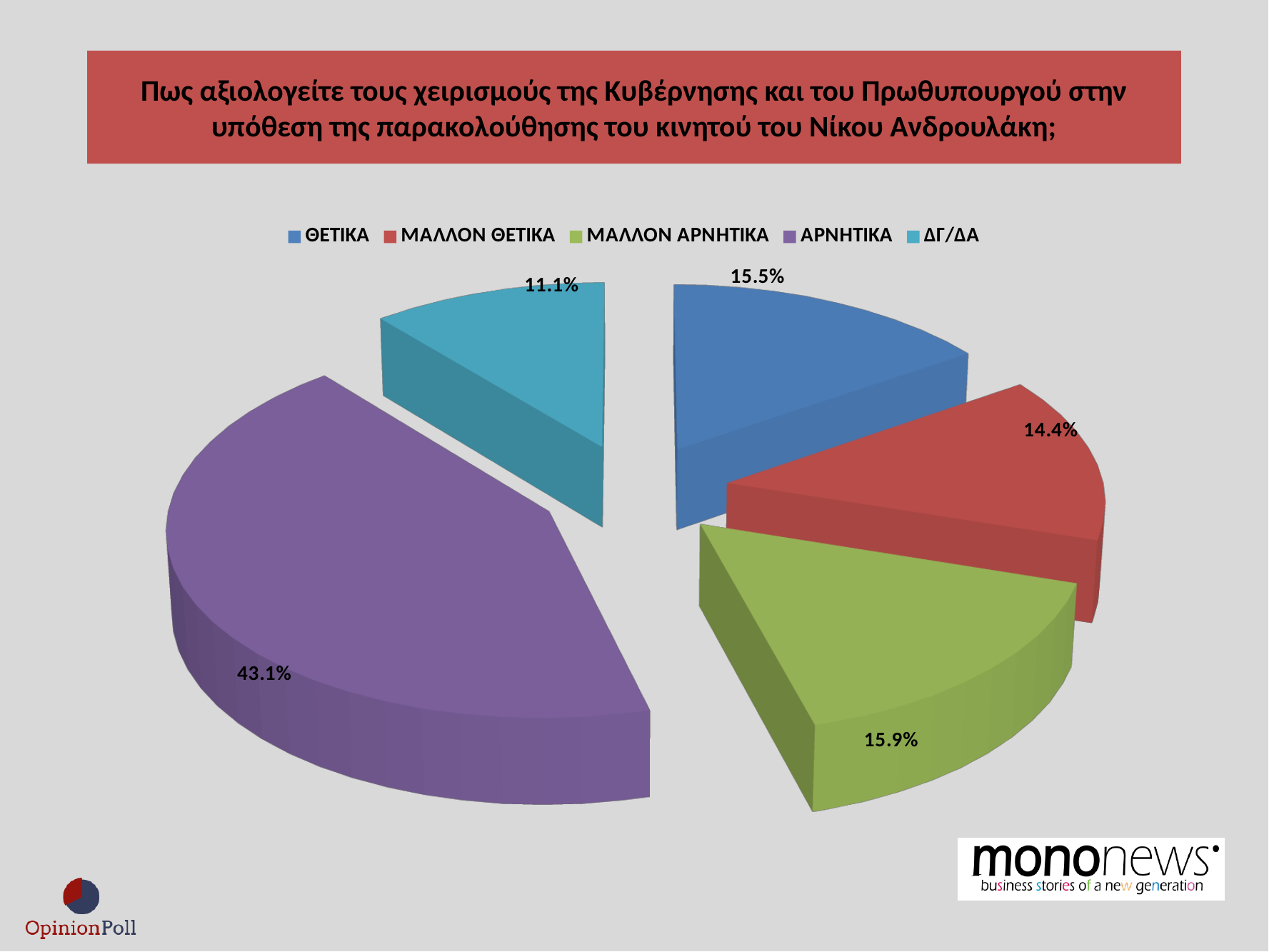
Which response category has the largest share of the pie? ΑΡΝΗΤΙΚΑ Which is larger, the share for ΘΕΤΙΚΑ or the share for ΜΑΛΛΟΝ ΘΕΤΙΚΑ? ΘΕΤΙΚΑ What percentage of respondents answered ΔΓ/ΔΑ? 11.1% What percentage of respondents answered ΑΡΝΗΤΙΚΑ? 43.1% What percentage of respondents answered ΘΕΤΙΚΑ? 15.5% What percentage of respondents answered ΜΑΛΛΟΝ ΑΡΝΗΤΙΚΑ? 15.9% What colour is the slice for ΑΡΝΗΤΙΚΑ? Purple What is the difference in percentage points between ΑΡΝΗΤΙΚΑ and ΜΑΛΛΟΝ ΑΡΝΗΤΙΚΑ? 27.2 How many slices does the pie chart have? 5 What is the combined share of ΘΕΤΙΚΑ and ΜΑΛΛΟΝ ΘΕΤΙΚΑ? 29.9% What kind of chart is shown on the slide? Pie chart Which response category has the smallest share of the pie? ΔΓ/ΔΑ